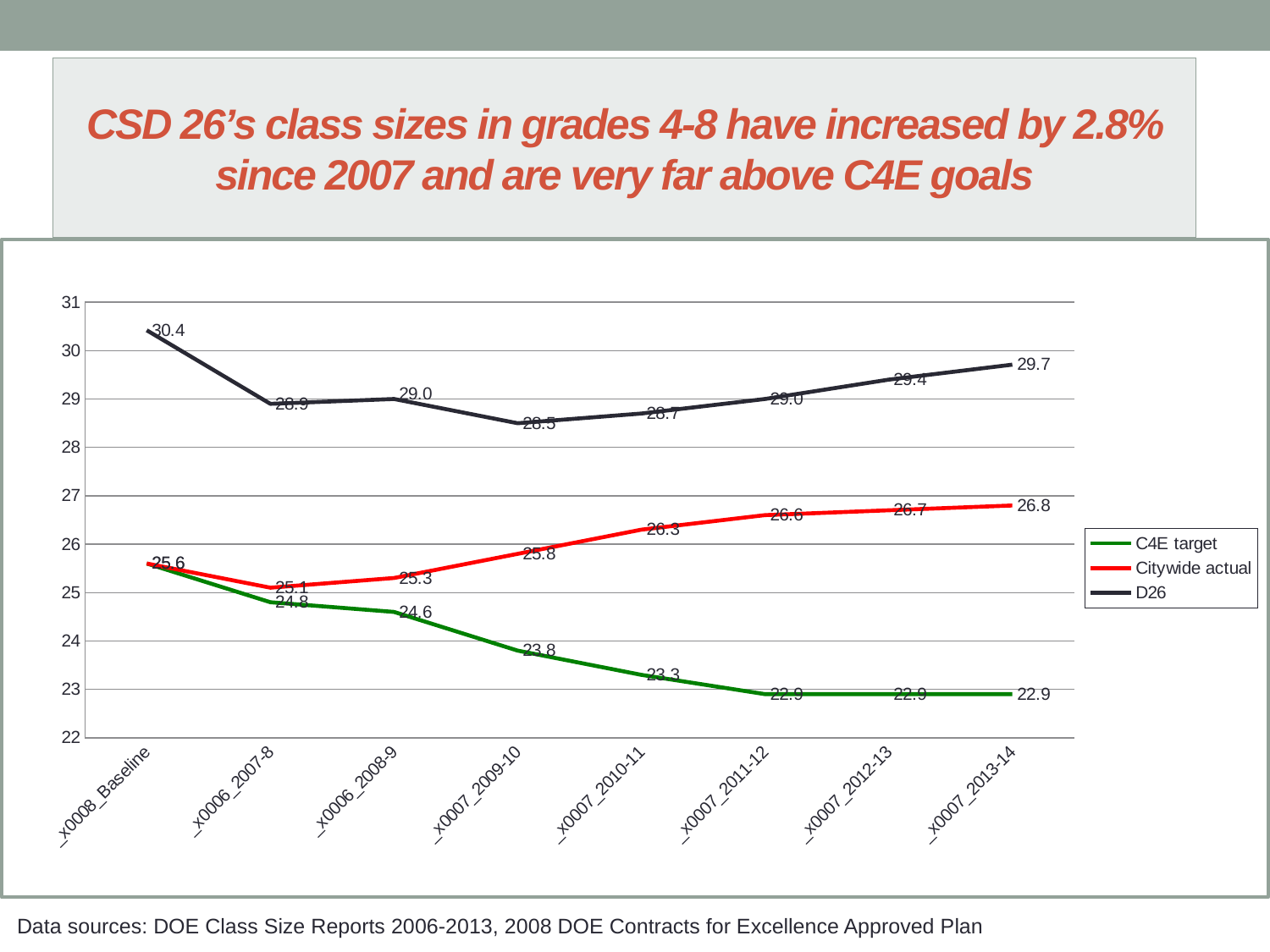
How many points are plotted along the x axis for each series? 8 What is the D26 value at the Baseline point? 30.4 Which is larger for 2011-12, the Citywide actual value or the C4E target value? Citywide actual At which x-axis point is the D26 series lowest? 2009-10 What is the C4E target value for 2009-10? 23.8 What is the difference between the D26 value and the C4E target value for 2013-14? 6.8 Does the C4E target series rise or fall from Baseline to 2011-12? fall What type of chart is shown on the slide? line chart Which series is drawn in red in the legend? Citywide actual How many series does the legend list? 3 At which x-axis point is the D26 series highest? Baseline What is the Citywide actual value for 2013-14? 26.8